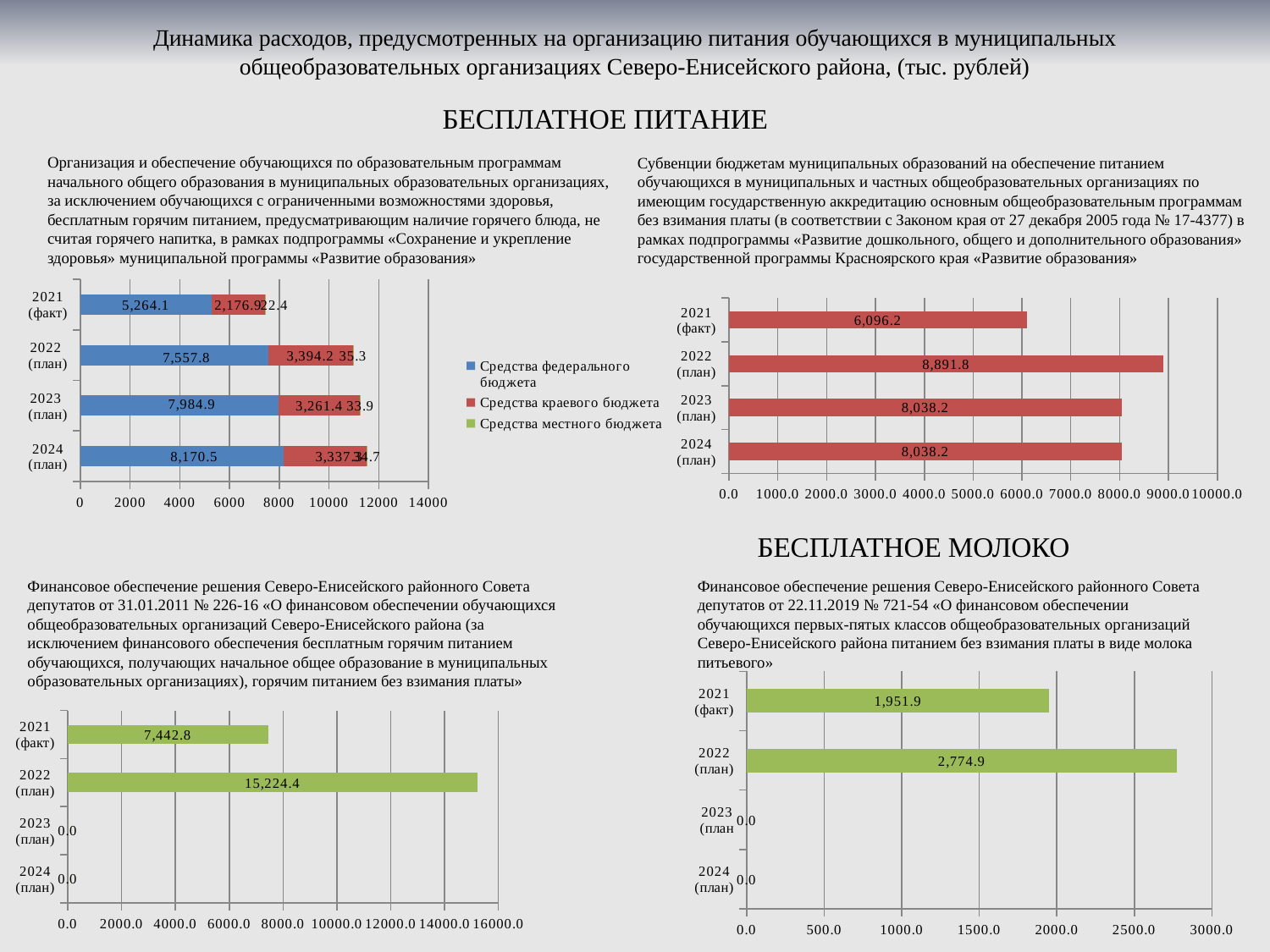
In the bottom-right chart, what is the difference between the 2022 (план) value and the 2021 (факт) value? 823.0 In the bottom-left chart, what is the value for 2022 (план)? 15,224.4 In the bottom-left chart, which year has the highest value? 2022 (план) In the top-right chart, what is the value for 2022 (план)? 8,891.8 In the top-left chart, what is the value of Средства федерального бюджета for 2024 (план)? 8,170.5 What type of chart is the top-left chart? Stacked bar chart In the top-left chart, how many series does the legend list? 3 In the bottom-left chart, how many year categories are shown? 4 In the top-right chart, what is the difference between the 2022 (план) value and the 2021 (факт) value? 2,795.6 In the bottom-right chart, is the value for 2022 (план) greater or less than 2500.0? greater In the top-right chart, which year has the lowest value? 2021 (факт) In the bottom-right chart, what is the value for 2021 (факт)? 1,951.9